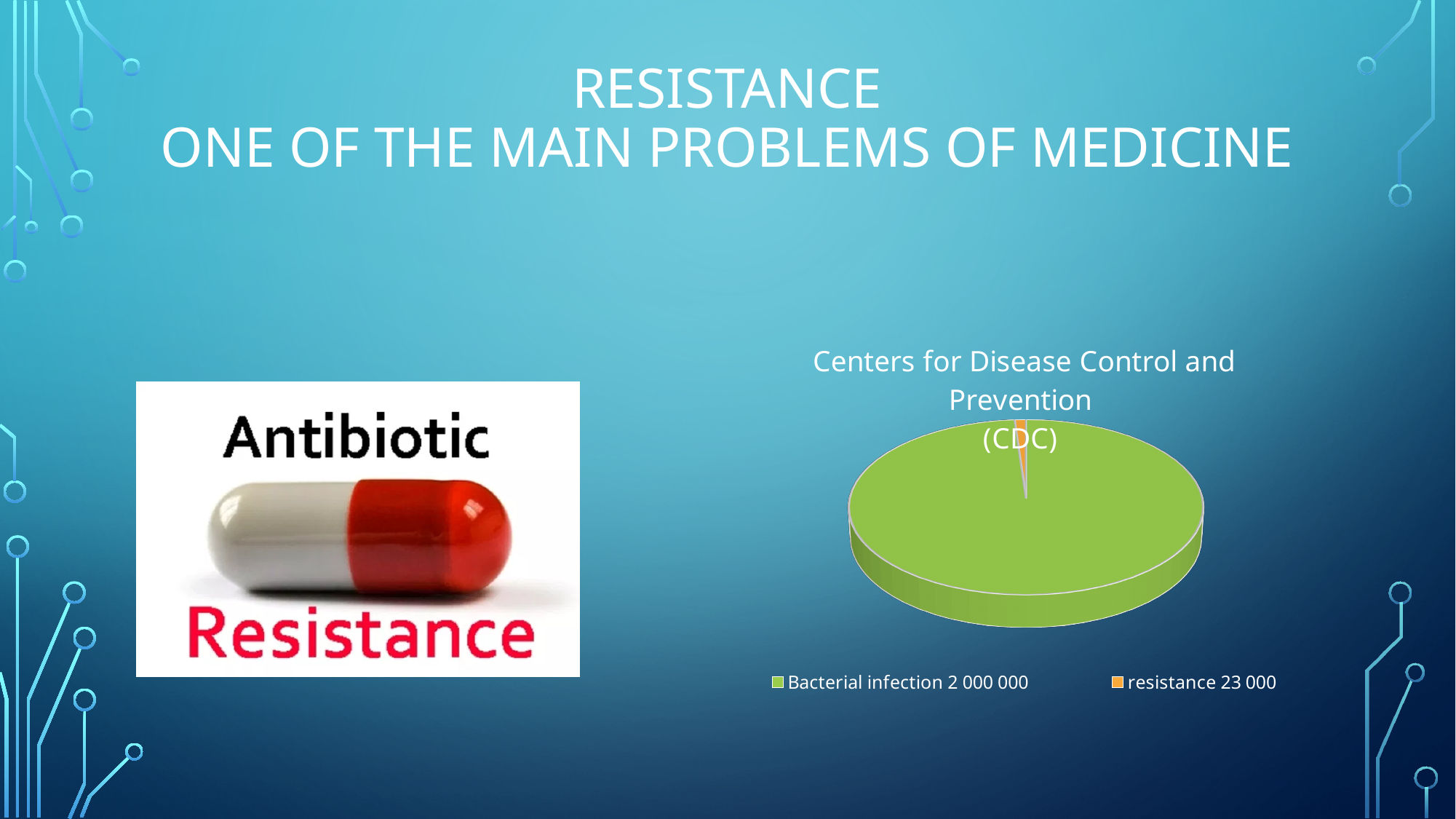
What number is given in the legend for Bacterial infection? 2 000 000 Which slice of the pie chart is the smallest? resistance 23 000 What is the difference between the Bacterial infection value and the resistance value shown in the legend? 1 977 000 How many entries does the chart legend list? 2 What kind of chart is shown on the slide? pie chart Which slice of the pie chart is the largest? Bacterial infection 2 000 000 What colour is the slice for Bacterial infection? green What number is given in the legend for resistance? 23 000 Which is larger, the value for Bacterial infection or the value for resistance? Bacterial infection How many slices does the pie chart have? 2 What is the title of the chart? Centers for Disease Control and Prevention (CDC)